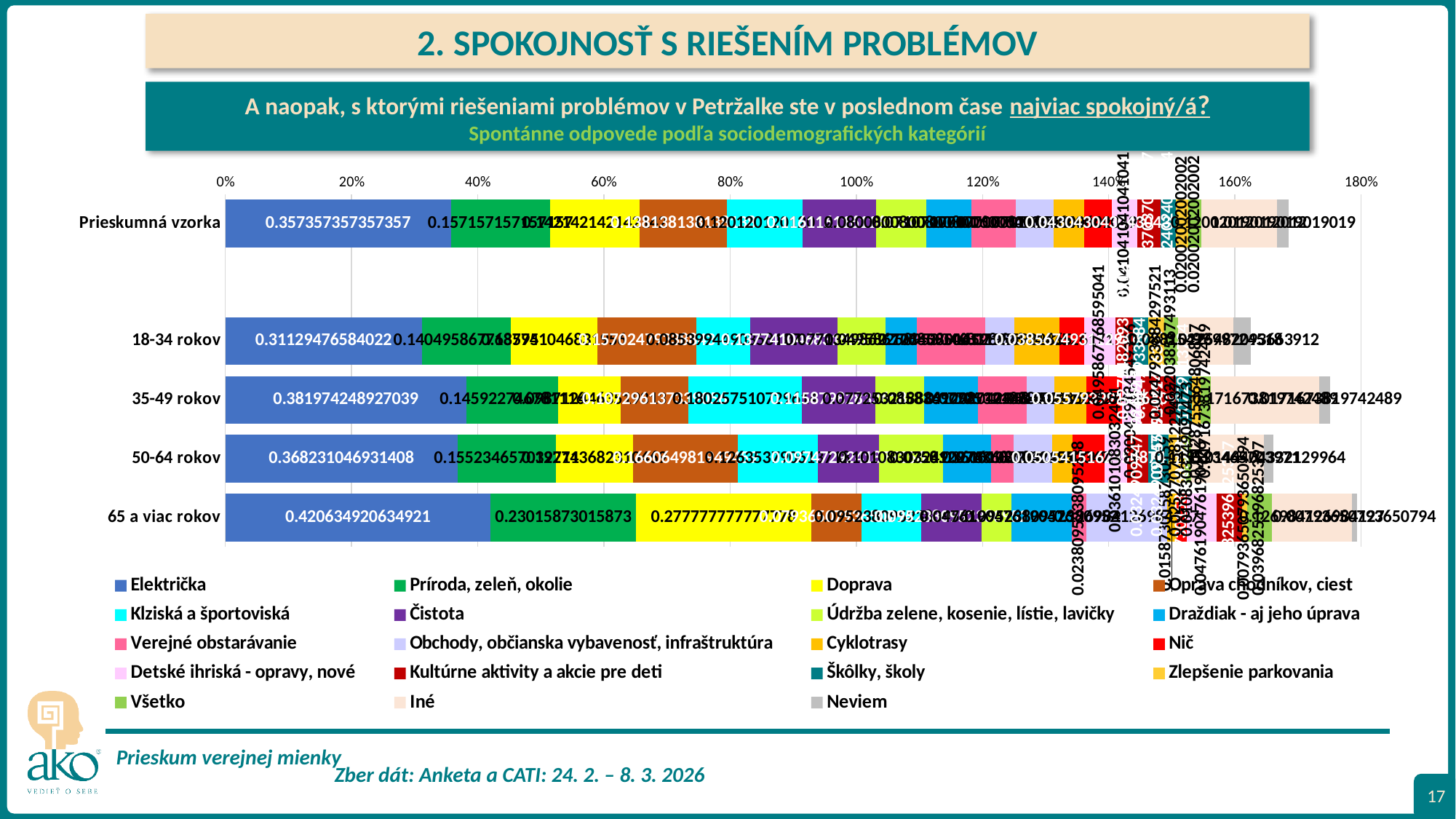
What kind of chart is shown on the slide? stacked bar chart How many categories (rows) are plotted on the chart? 5 Is the Električka value for 18-34 rokov greater or less than 40%? less Which category has the highest value for Električka? 65 a viac rokov Which category has the lowest value for Električka? 18-34 rokov What is the difference between the Električka values for 65 a viac rokov and Prieskumná vzorka? 0.063277563277564 What is the value of Električka for 18-34 rokov? 0.31129476584022 How many series does the chart legend list? 19 What is the value of Električka for Prieskumná vzorka? 0.357357357357357 What is the value of Električka for 65 a viac rokov? 0.420634920634921 What is the value of Električka for 35-49 rokov? 0.381974248927039 What is the value of Príroda, zeleň, okolie for 65 a viac rokov? 0.23015873015873